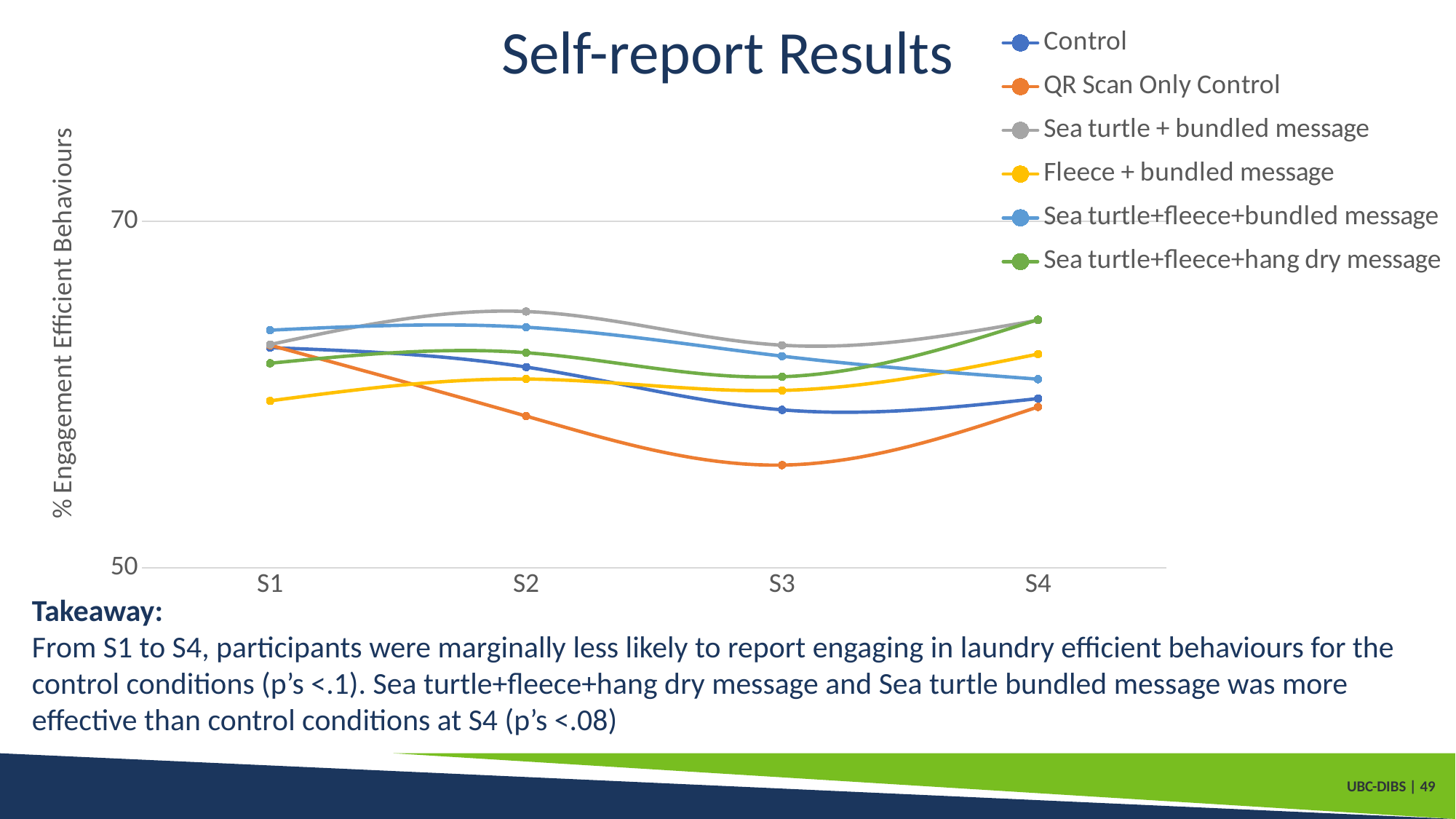
What kind of chart is shown on the slide? line chart Does the QR Scan Only Control series rise or fall from S1 to S3? fall Which series has the lowest value at S1? Fleece + bundled message Does the Sea turtle+fleece+hang dry message series rise or fall from S2 to S4? rise At S1, which is larger: Sea turtle+fleece+bundled message or Fleece + bundled message? Sea turtle+fleece+bundled message How many points are there along the x axis? 4 What is the label on the y axis? % Engagement Efficient Behaviours Is the value for QR Scan Only Control at S3 greater or less than 70? less Which series has the lowest value at S3? QR Scan Only Control At S3, which is larger: Control or QR Scan Only Control? Control How many series does the legend list? 6 Which series has the highest value at S2? Sea turtle + bundled message